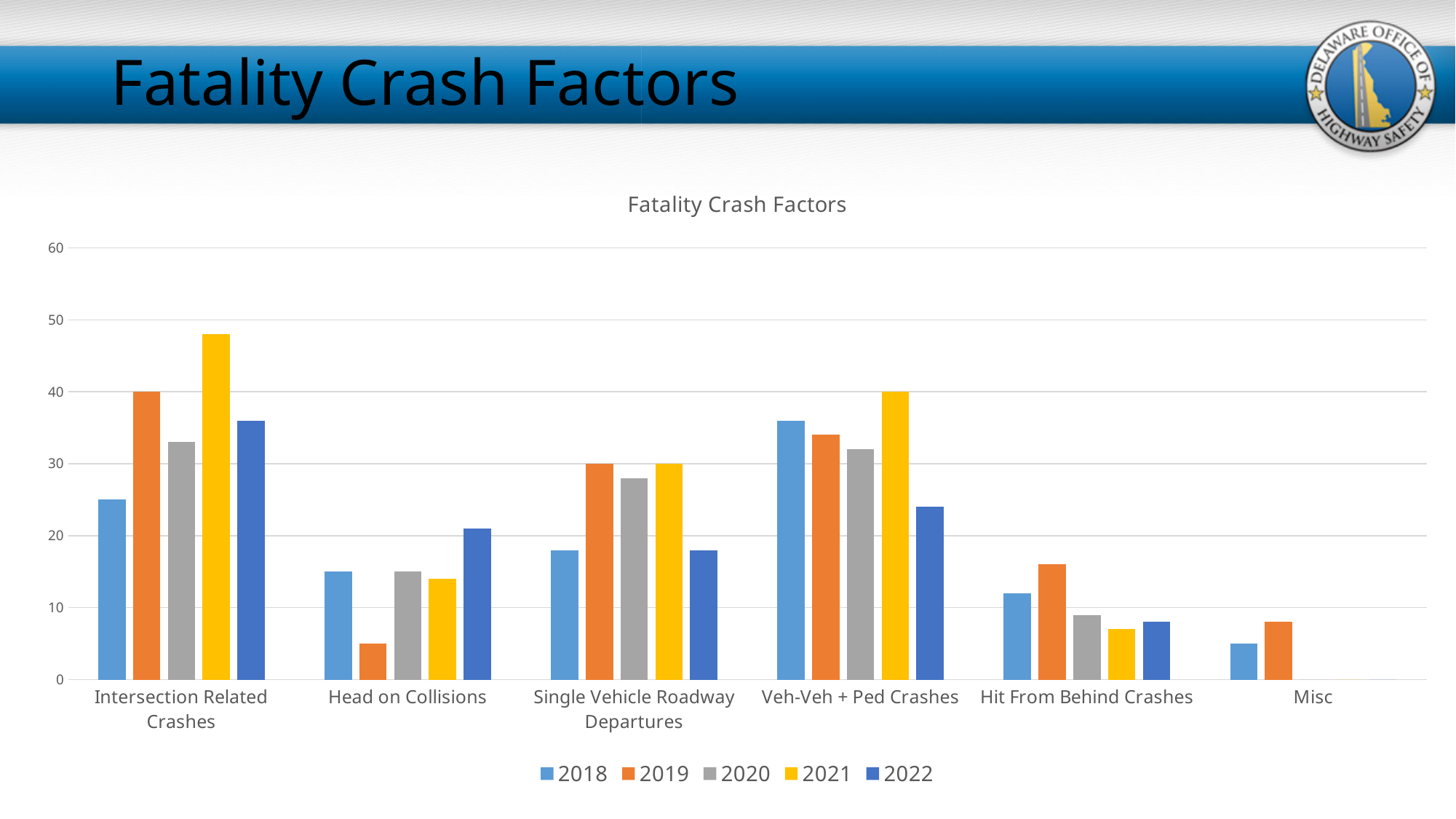
What is the title of the chart? Fatality Crash Factors Is the 2021 value for Intersection Related Crashes greater or less than 40? greater What is the 2019 value for Intersection Related Crashes? 40 Which category has the lowest 2018 bar? Misc How many series does the legend list? 5 What is the 2021 value for Veh-Veh + Ped Crashes? 40 How many crash factor categories are shown on the x axis? 6 For Veh-Veh + Ped Crashes, which year has the larger value, 2018 or 2022? 2018 For Head on Collisions, which year has the larger value, 2018 or 2022? 2022 Is the 2019 value for Head on Collisions greater or less than 10? less Which category has the highest 2021 bar? Intersection Related Crashes What kind of chart is shown on the slide? bar chart